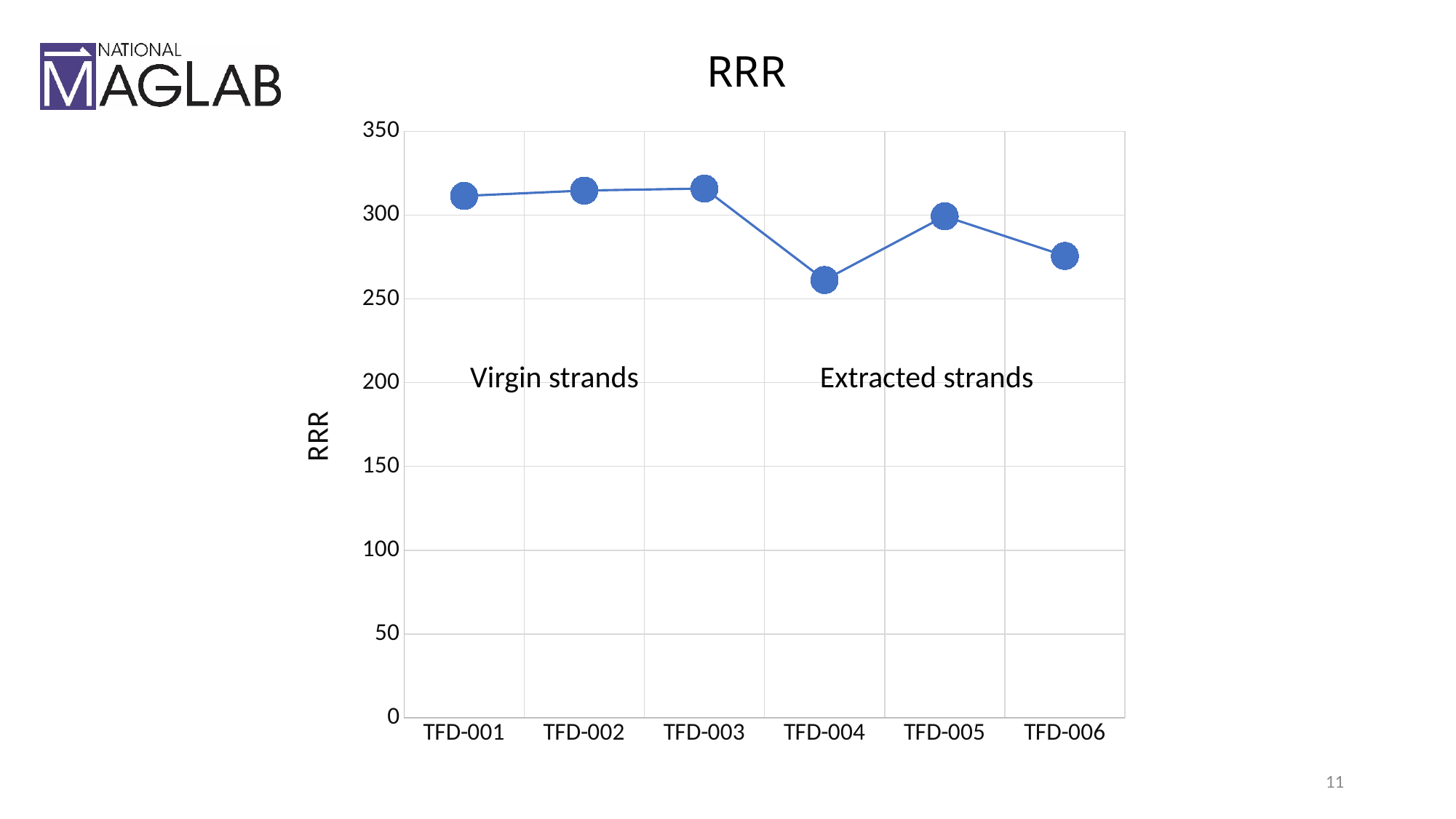
Is the RRR value for TFD-004 greater or less than 250? greater Which strand has the lowest RRR value? TFD-004 Is the RRR value for TFD-001 greater or less than 300? greater Does the RRR value rise or fall from TFD-003 to TFD-004? fall Which has the larger RRR value, TFD-004 or TFD-005? TFD-005 What kind of chart is shown on the slide? line chart What is the title of the chart? RRR Is the RRR value for TFD-006 greater or less than 300? less How many strands (categories) are plotted on the x axis? 6 What label is written over the first three strands on the chart? Virgin strands Which has the larger RRR value, TFD-003 or TFD-006? TFD-003